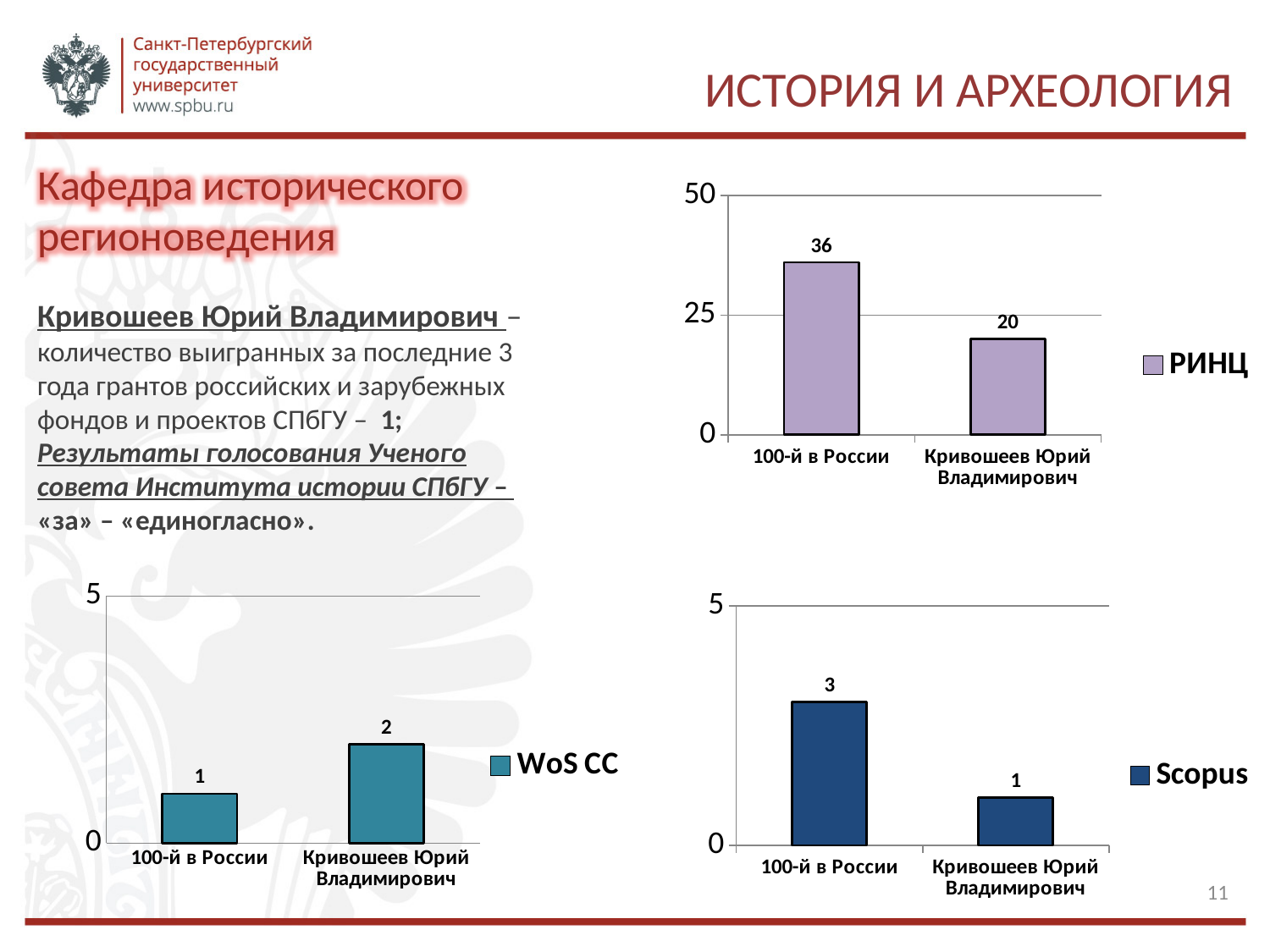
What type of chart is the WoS CC chart? bar chart How many categories are shown in the Scopus chart? 2 In the РИНЦ chart, what is the difference between the values for 100-й в России and Кривошеев Юрий Владимирович? 16 In the РИНЦ chart, what is the value for Кривошеев Юрий Владимирович? 20 In the РИНЦ chart, which category has the higher value? 100-й в России In the Scopus chart, is the value for 100-й в России larger or smaller than the value for Кривошеев Юрий Владимирович? larger In the WoS CC chart, what is the value for 100-й в России? 1 In the Scopus chart, what is the value for 100-й в России? 3 In the WoS CC chart, what is the value for Кривошеев Юрий Владимирович? 2 In the РИНЦ chart, what is the value for 100-й в России? 36 In the Scopus chart, what is the value for Кривошеев Юрий Владимирович? 1 In the WoS CC chart, which category has the lower value? 100-й в России